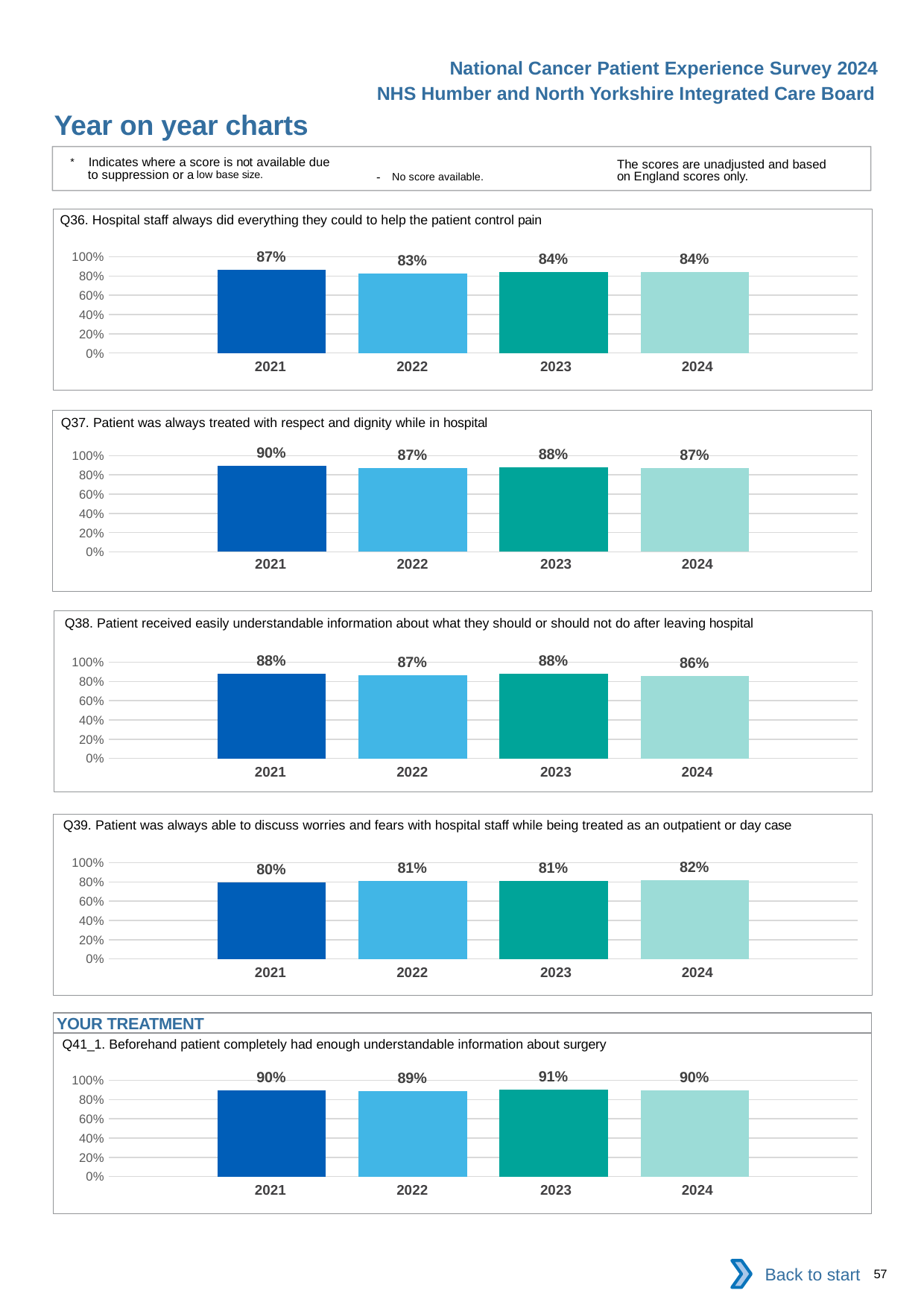
In the Q36 chart, what is the difference between the 2021 and 2022 values? 4 percentage points In the Q38 chart, is the value for 2023 larger or smaller than the value for 2022? larger In the Q38 chart (patient received easily understandable information about what they should or should not do after leaving hospital), which year has the lowest value? 2024 In the Q37 chart, what is the value for 2024? 87% How many years are plotted in the Q41_1 chart? 4 In the Q39 chart, what is the value for 2024? 82% In the Q36 chart, which year has the lowest value? 2022 In the Q36 chart (hospital staff always did everything they could to help the patient control pain), what is the value for 2021? 87% What kind of chart is the Q36 chart? bar chart In the Q37 chart (patient was always treated with respect and dignity while in hospital), which year has the highest value? 2021 In the Q41_1 chart (beforehand patient completely had enough understandable information about surgery), which year has the highest value? 2023 In the Q39 chart (patient was always able to discuss worries and fears with hospital staff while being treated as an outpatient or day case), do the values rise or fall from 2021 to 2024? rise